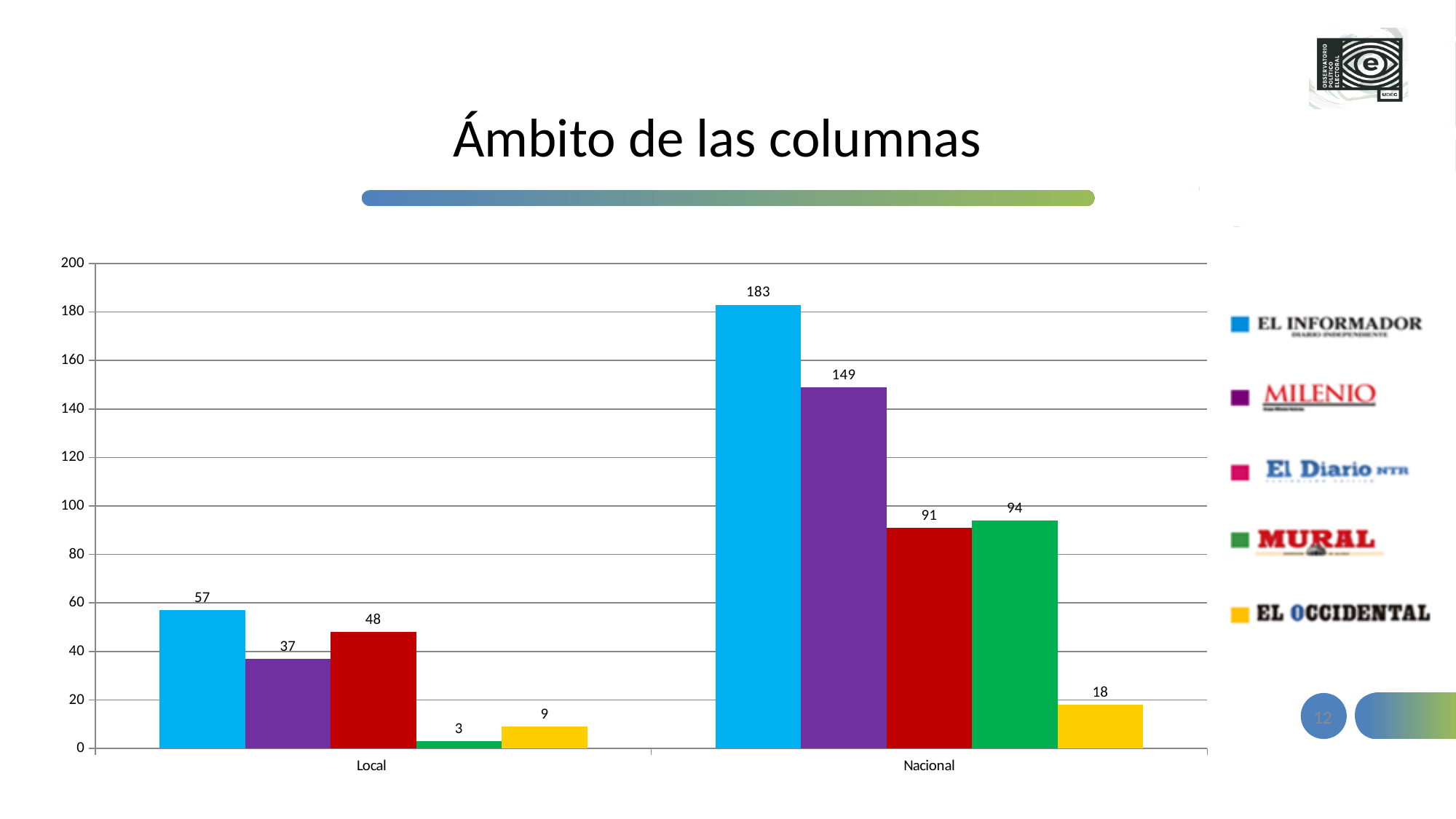
Which newspaper has the highest value in the Nacional category? El Informador How many newspapers (series) are listed in the legend? 5 In the Nacional category, which is larger: the value for El Diario NTR or the value for Mural? Mural What kind of chart is shown on the slide? Bar chart What is the value for El Occidental in the Local category? 9 Which newspaper has the lowest value in the Local category? Mural What is the title of the slide? Ámbito de las columnas How many categories are shown on the x axis? 2 What is the value for Mural in the Local category? 3 What is the value for El Informador in the Nacional category? 183 What is the value for Milenio in the Nacional category? 149 What is the difference between El Informador's Nacional value and its Local value? 126